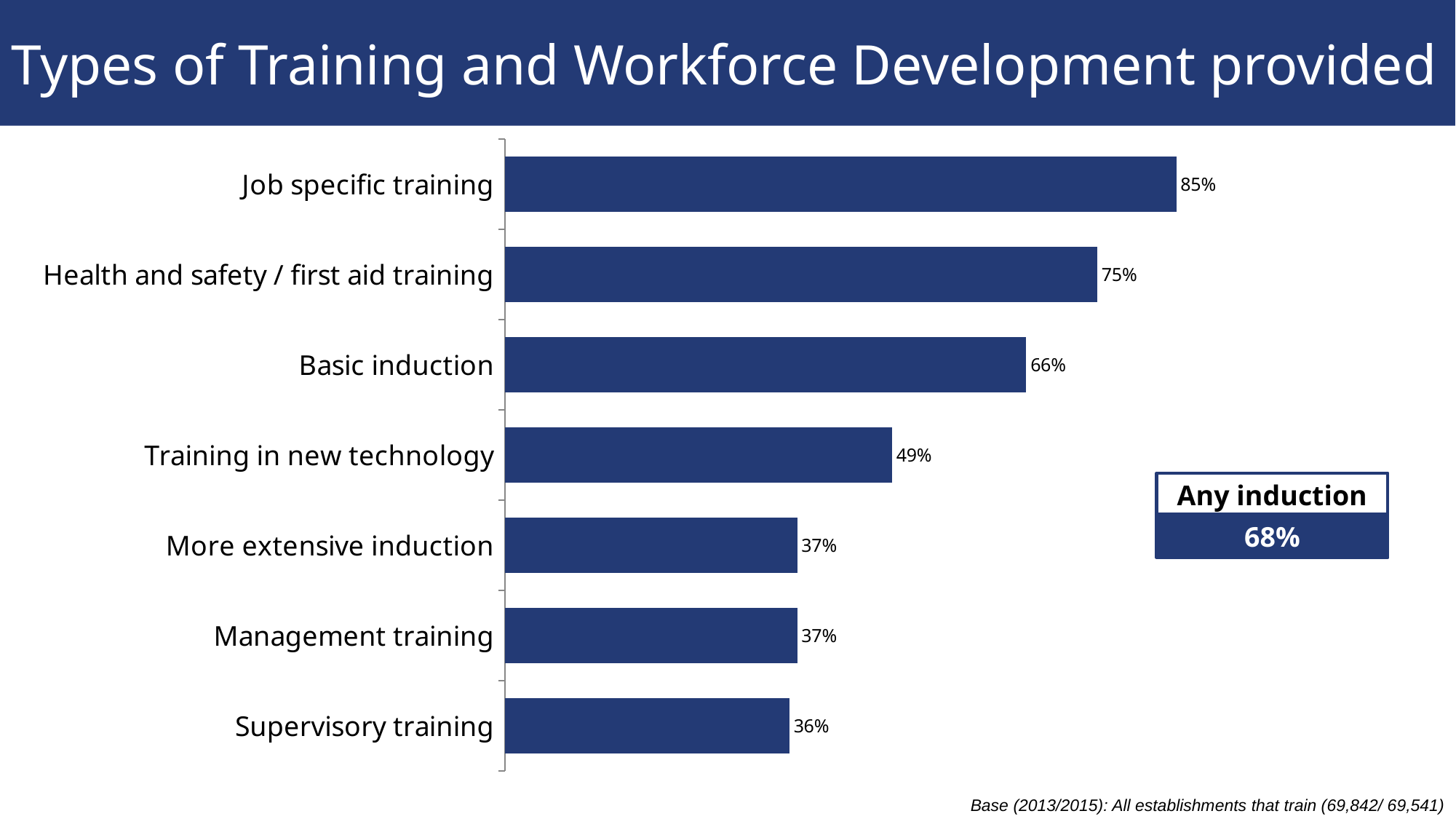
What is the difference between the values for Job specific training and Basic induction? 19% What is the value for Supervisory training? 36% How many types of training are shown in the chart? 7 Which type of training has the lowest value? Supervisory training What value is shown in the 'Any induction' box on the slide? 68% What is the value for Health and safety / first aid training? 75% What is the difference between the values for Basic induction and More extensive induction? 29% What is the value for Job specific training? 85% Which type of training has the highest value? Job specific training What is the value for Training in new technology? 49% Which is larger, the value for Health and safety / first aid training or the value for Training in new technology? Health and safety / first aid training What kind of chart is shown on the slide? Bar chart